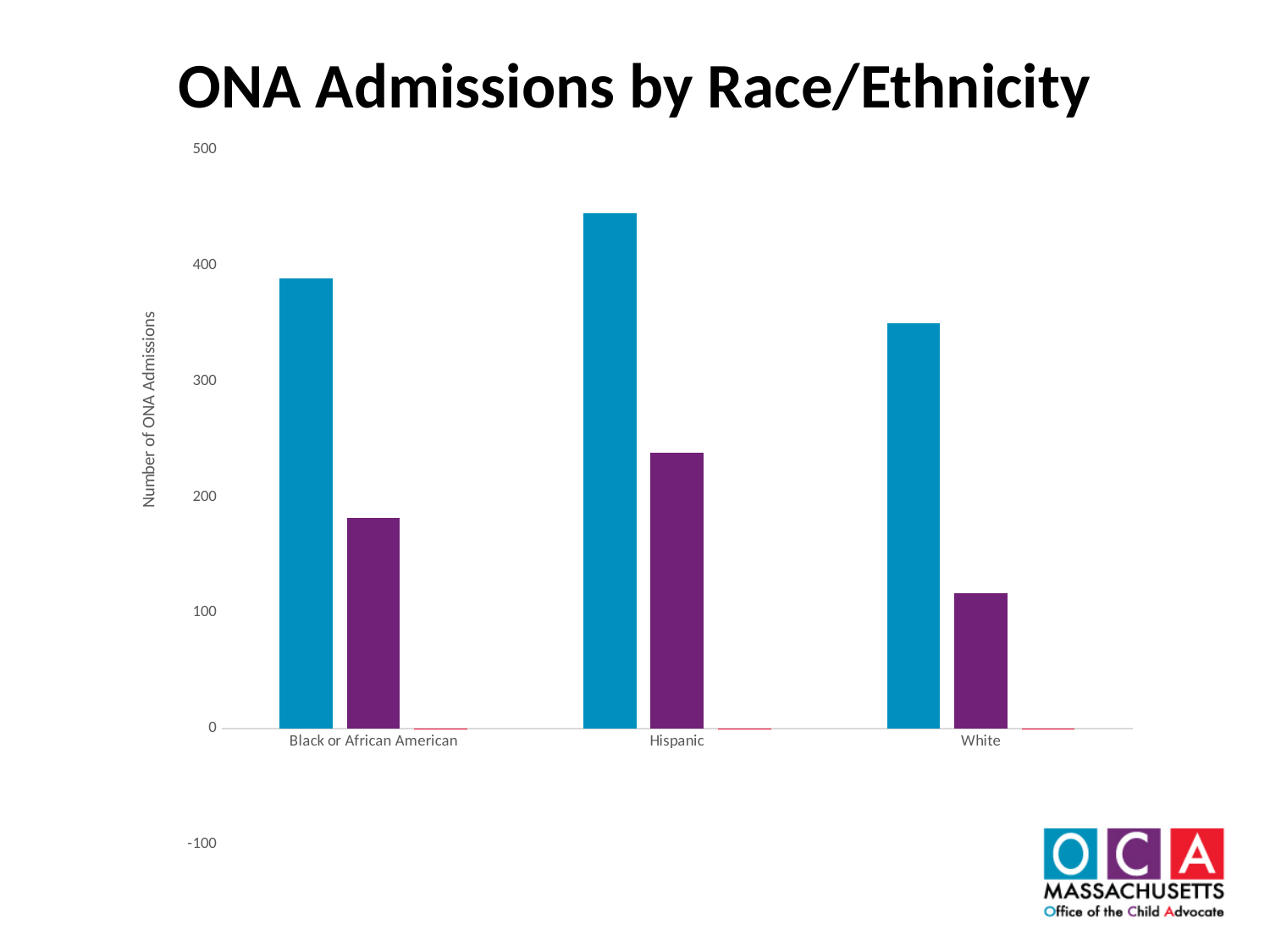
What kind of chart is shown on the slide? bar chart What is the label of the vertical axis? Number of ONA Admissions Which category has the shortest blue bar? White Which category has the shortest purple bar? White How many race/ethnicity categories are shown on the x axis? 3 Is the blue bar for Black or African American greater or less than 300? greater Which category has the tallest blue bar? Hispanic Is the purple bar for Hispanic greater or less than 200? greater Is the blue bar for Hispanic greater or less than 400? greater What is the title of the chart? ONA Admissions by Race/Ethnicity Within the Black or African American category, which bar is taller, the blue one or the purple one? the blue one